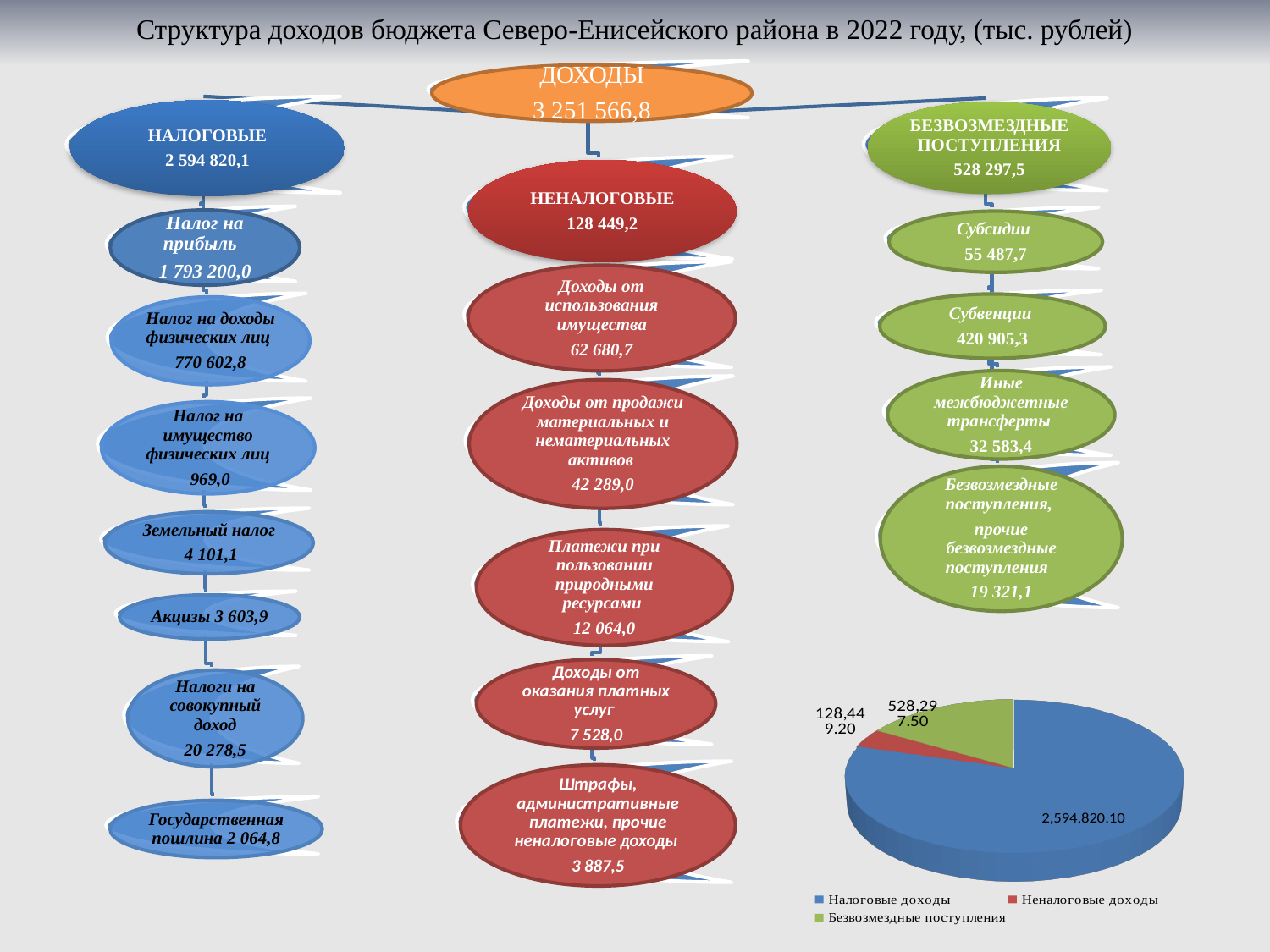
Which category has the smallest slice in the pie chart? Неналоговые доходы What colour is the Налоговые доходы slice in the pie chart? blue What colour is the Безвозмездные поступления slice in the pie chart? green What kind of chart is shown in the bottom right of the slide? pie chart In the pie chart, which is larger: Безвозмездные поступления or Неналоговые доходы? Безвозмездные поступления In the pie chart, what is the value shown for Налоговые доходы? 2,594,820.10 How many entries does the legend of the pie chart list? 3 How many slices does the pie chart have? 3 In the pie chart, which is larger: Налоговые доходы or Безвозмездные поступления? Налоговые доходы Which category has the largest slice in the pie chart? Налоговые доходы